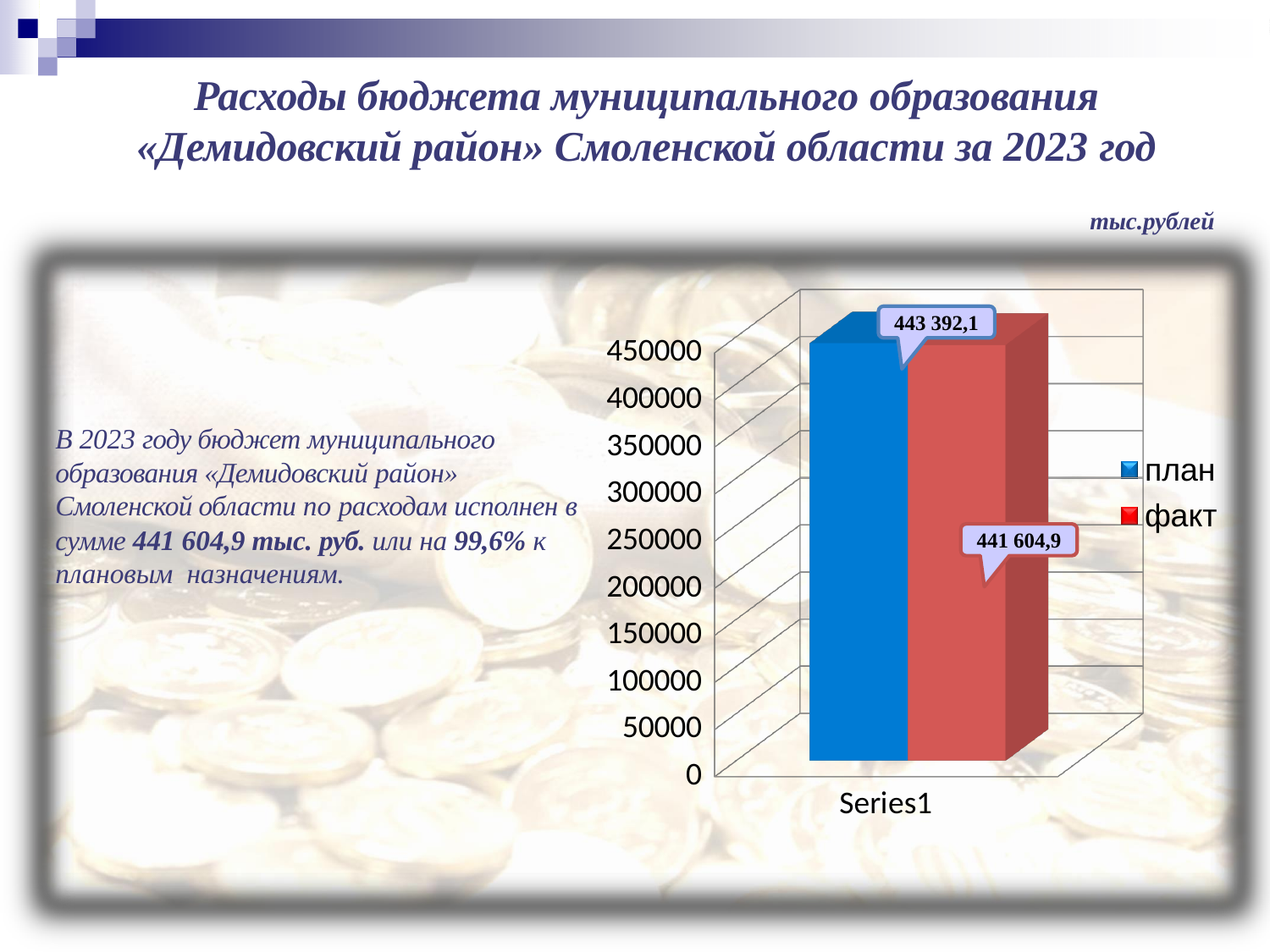
What is the difference between the план value and the факт value? 1 787,2 What is the value of the план (plan) bar? 443 392,1 Which series has the higher value according to the data labels, план or факт? план What is the highest tick value shown on the vertical axis? 450000 What colour is the факт series in the chart? red What unit is stated above the chart? тыс.рублей What is the value of the факт (actual) bar? 441 604,9 Is the value for факт greater or less than 400000? greater What kind of chart is shown on the slide? bar chart How many series does the legend list? 2 How many categories are shown on the x axis? 1 Is the value for план greater or less than 350000? greater